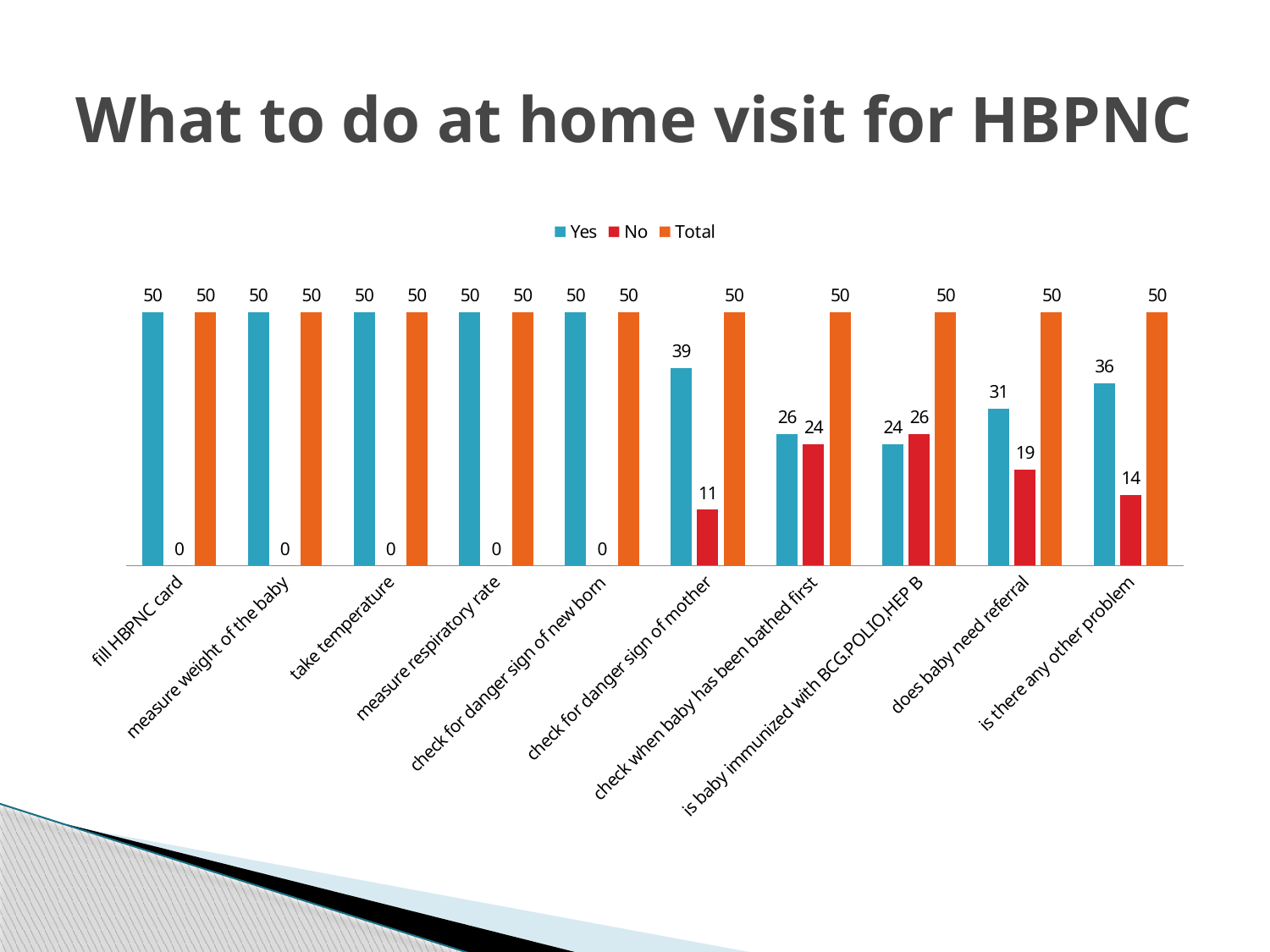
What is the No value for 'does baby need referral'? 19 What kind of chart is shown on the slide? bar chart How many categories are shown on the x axis? 10 Which is larger for 'does baby need referral', the Yes value or the No value? Yes Which category has the highest No value? is baby immunized with BCG,POLIO,HEP B How many series does the legend list? 3 What is the Yes value for 'is baby immunized with BCG,POLIO,HEP B'? 24 Which category has the lowest Yes value? is baby immunized with BCG,POLIO,HEP B What is the Yes value for 'check for danger sign of mother'? 39 What is the No value for 'is there any other problem'? 14 What is the difference between the Yes and No values for 'check when baby has been bathed first'? 2 What is the title of the slide? What to do at home visit for HBPNC